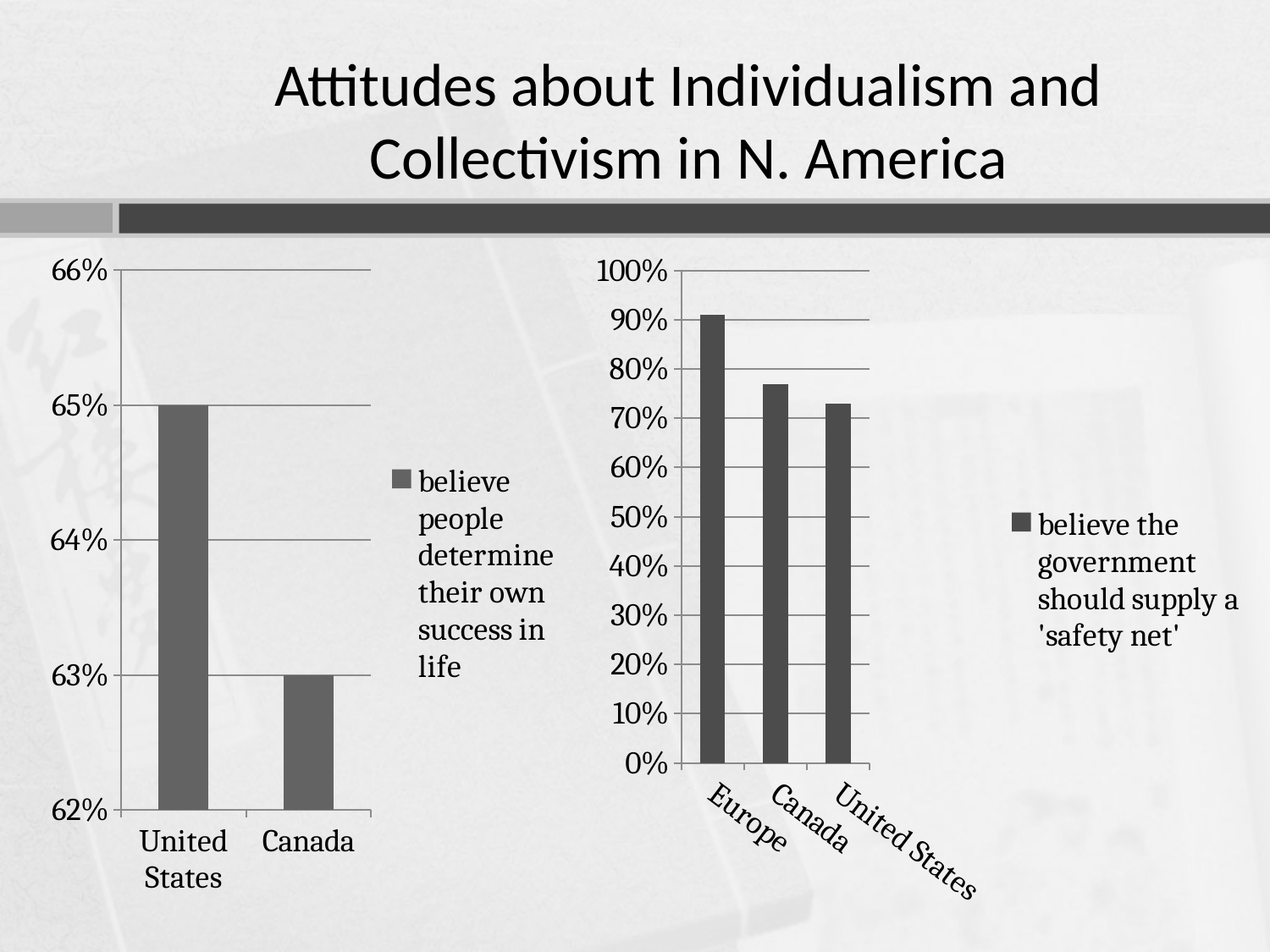
On the right chart, how many categories are shown? 3 On the right chart, is the value for United States greater or less than 80%? less On the left chart, what is the value for United States? 65% On the left chart, which country has the higher value? United States On the left chart, what is the value for Canada? 63% On the left chart, how many categories are shown? 2 On the right chart, which category has the lowest value? United States What is the legend entry on the right chart? believe the government should supply a 'safety net' On the right chart, which category has the highest value? Europe On the left chart, what is the difference between the United States and Canada values? 2% What type of chart is the right chart? bar chart On the right chart, is the value for Europe greater or less than 80%? greater